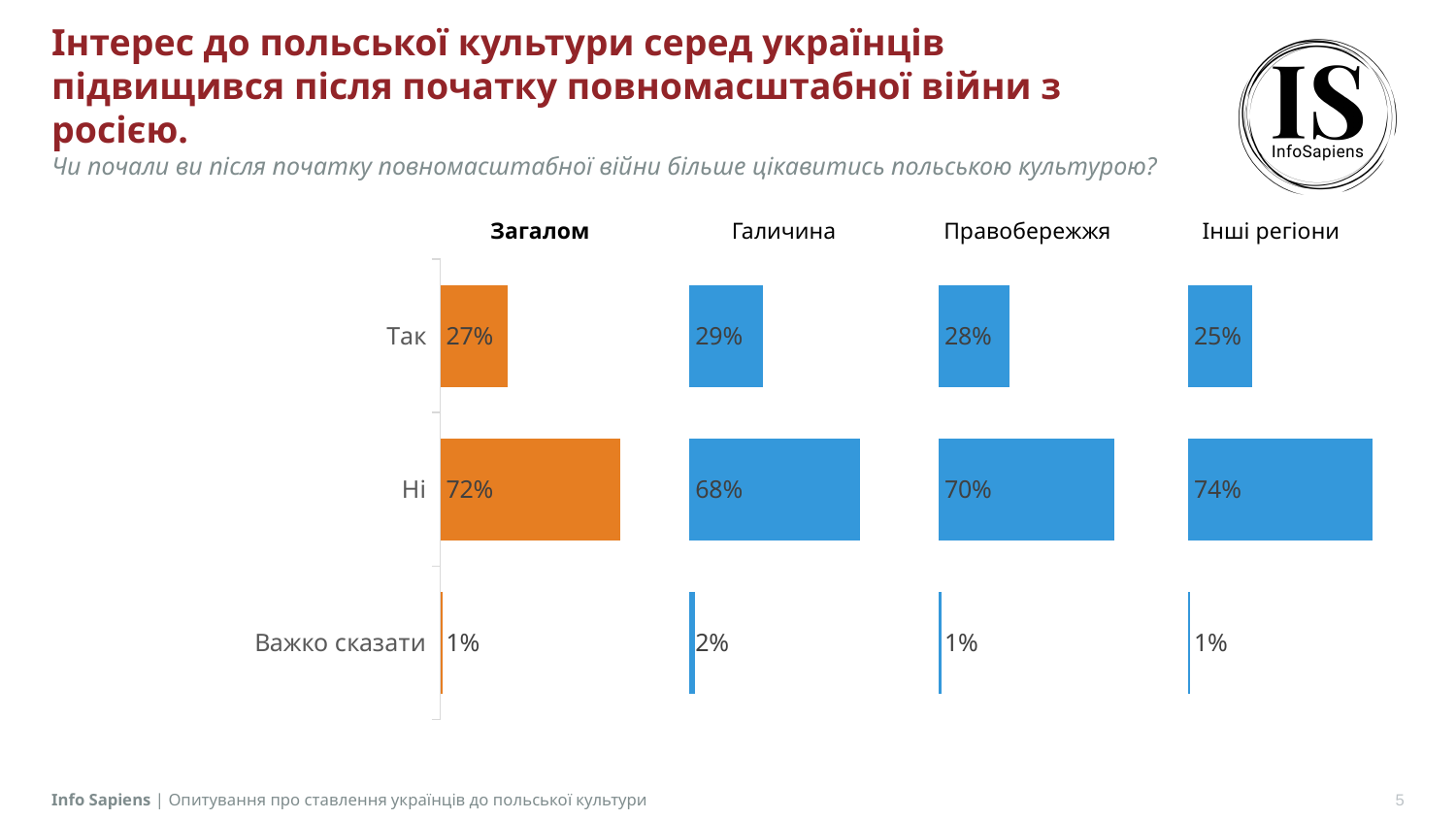
In the Галичина chart, which category has the lowest value? Важко сказати In the Інші регіони chart, what is the value for Так? 25% In the Загалом chart, which category has the highest value? Ні Which chart on the slide uses orange bars instead of blue? Загалом Which is larger: the value for Так in the Галичина chart or the value for Так in the Інші регіони chart? Галичина In the Галичина chart, what is the value for Ні? 68% How many categories are shown in the Правобережжя chart? 3 In the Загалом chart, what is the value for Так? 27% In the Правобережжя chart, what is the difference between the values for Ні and Так? 42% In the Правобережжя chart, what is the value for Важко сказати? 1% In the Інші регіони chart, what is the difference between the values for Ні and Так? 49% What kind of chart is used on this slide? Bar chart